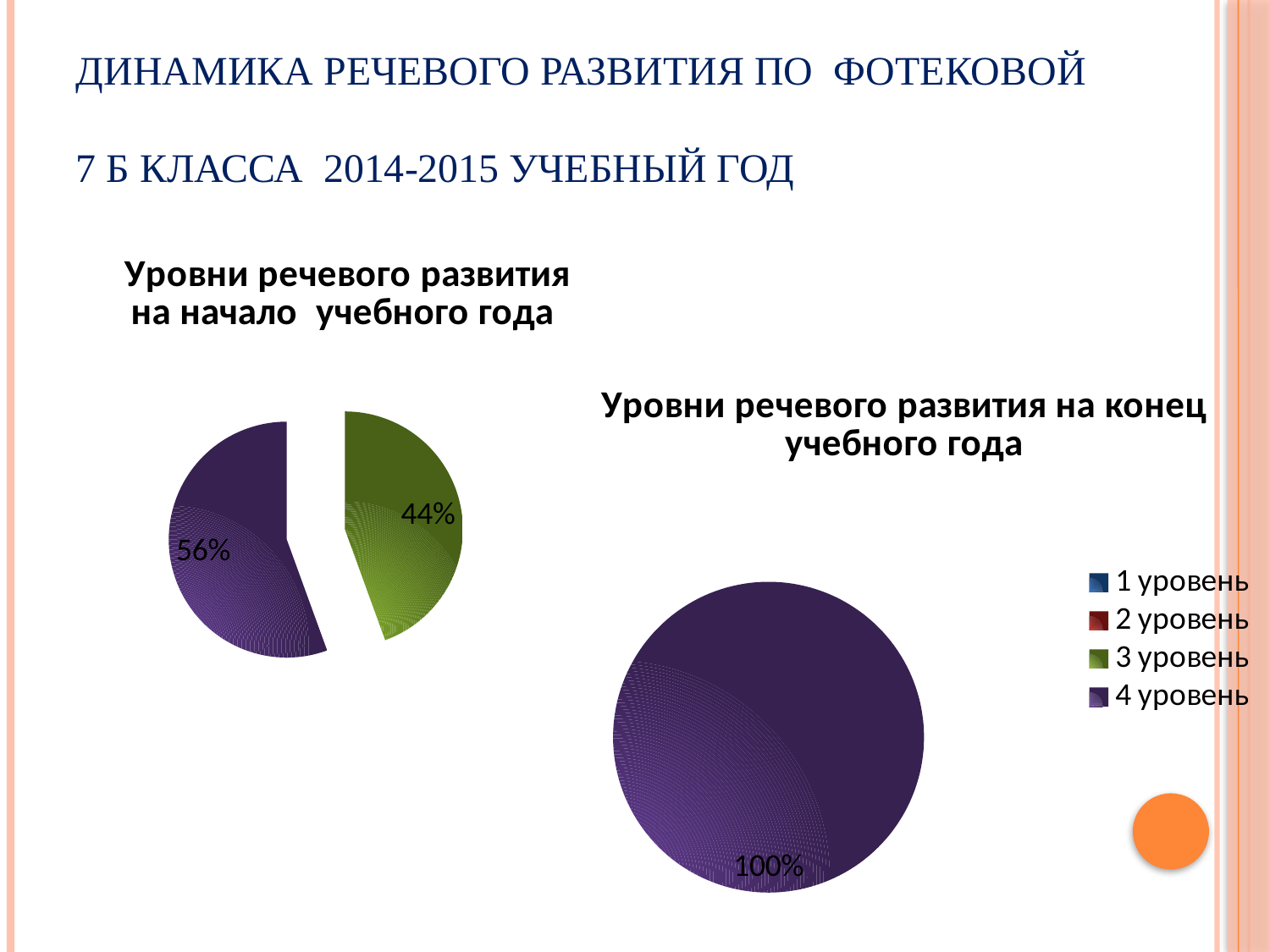
In the chart 'Уровни речевого развития на конец учебного года', what share is shown for the single slice? 100% In the chart 'Уровни речевого развития на начало учебного года', what is the difference in percentage points between the 4 уровень slice and the 3 уровень slice? 12 In the chart 'Уровни речевого развития на начало учебного года', how many slices are shown? 2 Which legend entry is shown in green? 3 уровень Is the 4 уровень share in the chart 'Уровни речевого развития на начало учебного года' larger or smaller than the 4 уровень share in the chart 'Уровни речевого развития на конец учебного года'? smaller In the chart 'Уровни речевого развития на конец учебного года', how many slices are shown? 1 In the chart 'Уровни речевого развития на начало учебного года', what share does the purple slice (4 уровень) have? 56% In the chart 'Уровни речевого развития на начало учебного года', what share does the green slice (3 уровень) have? 44% In the chart 'Уровни речевого развития на начало учебного года', which level has the smaller slice? 3 уровень In the chart 'Уровни речевого развития на начало учебного года', which level has the larger slice? 4 уровень What kind of chart is 'Уровни речевого развития на начало учебного года'? pie chart How many entries does the legend on the slide list? 4